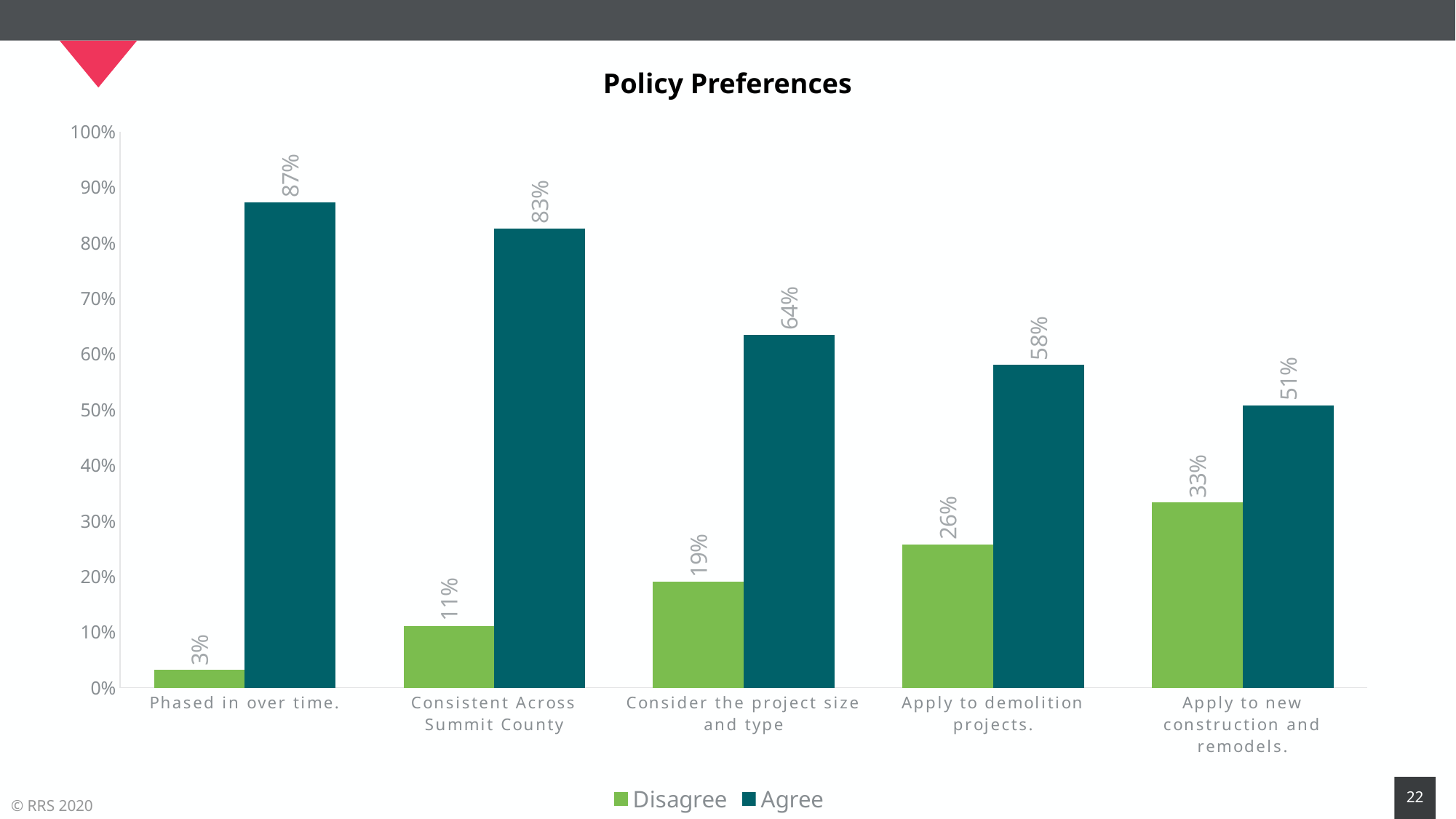
What is the Agree value for "Apply to new construction and remodels."? 51% How many policy categories are shown on the x axis? 5 How many series does the legend list? 2 What is the title of the chart? Policy Preferences What kind of chart is shown on the slide? Bar chart Which is larger for "Consider the project size and type": the Agree value or the Disagree value? Agree Which category has the highest Agree value? Phased in over time. What is the difference between the Agree and Disagree values for "Apply to demolition projects."? 32% What percentage of respondents agree that the policy should be phased in over time? 87% What is the Disagree value for "Consistent Across Summit County"? 11% Which category has the lowest Disagree value? Phased in over time. Do the Agree values rise or fall moving from left to right across the categories? Fall